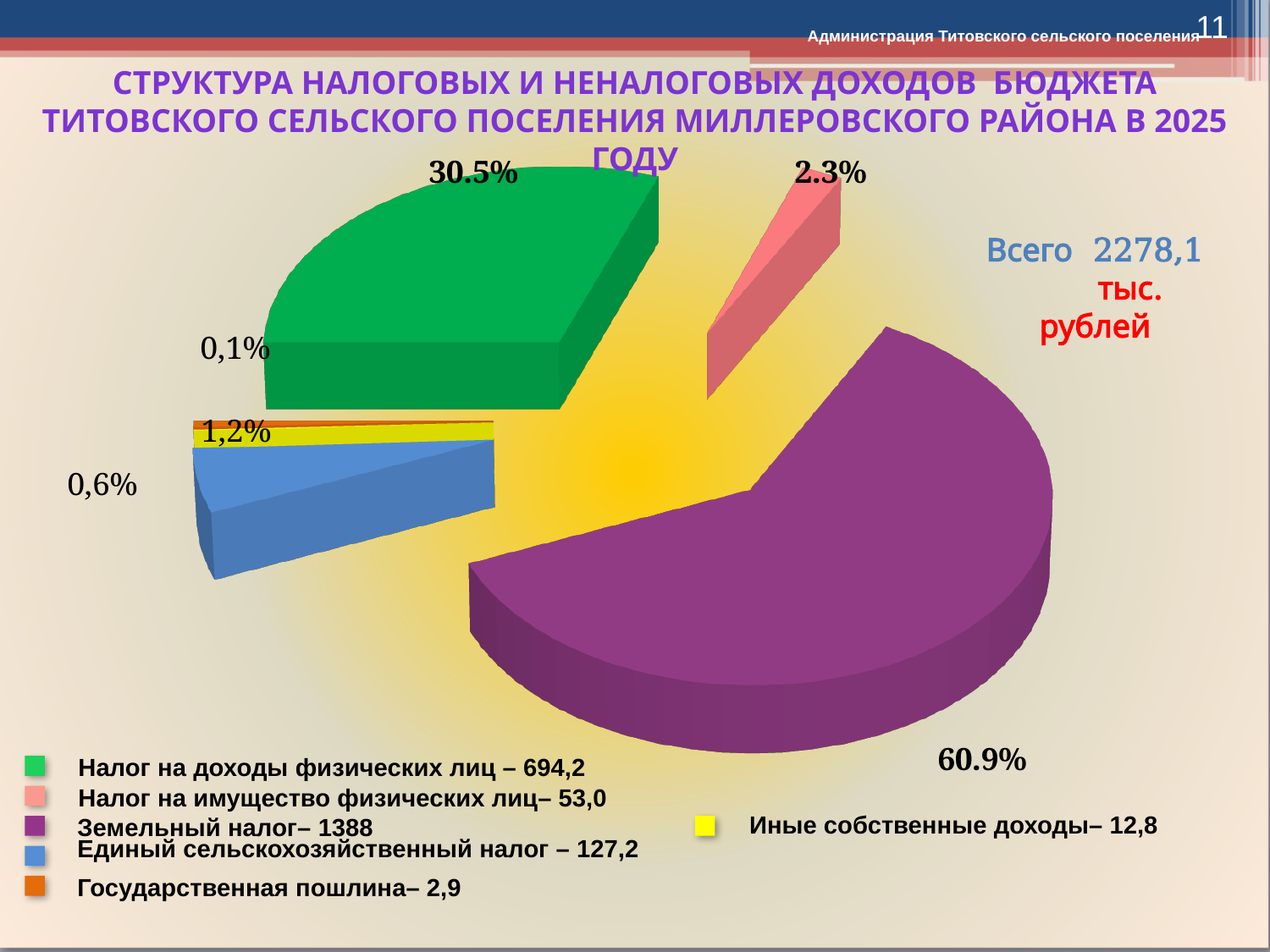
Which category has the smallest value according to the legend? Государственная пошлина Which is larger: Единый сельскохозяйственный налог or Иные собственные доходы? Единый сельскохозяйственный налог What share of the pie does Налог на доходы физических лиц account for? 30.5% What total amount (Всего) is stated on the slide? 2278,1 тыс. рублей What is the value for Иные собственные доходы shown in the legend? 12,8 What kind of chart is shown on the slide? pie chart What share of the pie does Земельный налог account for? 60.9% How many categories does the pie chart legend list? 6 What is the difference between the values for Налог на доходы физических лиц and Налог на имущество физических лиц? 641,2 What is the value for Единый сельскохозяйственный налог shown in the legend? 127,2 Which category has the largest slice of the pie? Земельный налог What share of the pie does Налог на имущество физических лиц account for? 2.3%